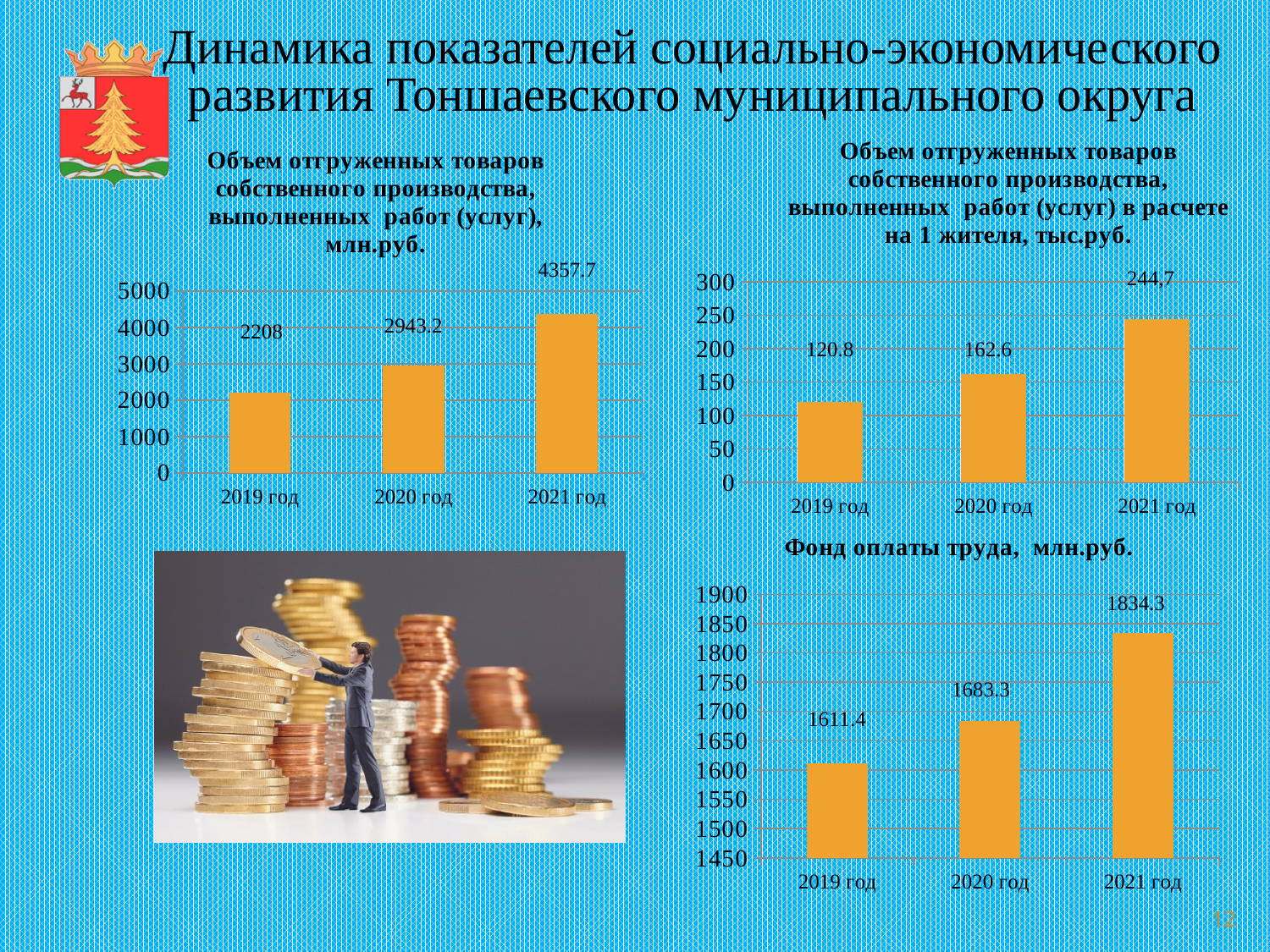
In the chart titled "Фонд оплаты труда, млн.руб.", what is the value for 2019 год? 1611.4 In the chart titled "Фонд оплаты труда, млн.руб.", which year has the highest value? 2021 год What type of chart is the chart titled "Фонд оплаты труда, млн.руб."? bar chart In the chart titled "Объем отгруженных товаров ... в расчете на 1 жителя, тыс.руб." (top right), what is the value for 2021 год? 244,7 In the chart titled "Объем отгруженных товаров собственного производства, выполненных работ (услуг), млн.руб.", what is the value for 2021 год? 4357.7 In the chart titled "Объем отгруженных товаров собственного производства, выполненных работ (услуг), млн.руб.", do the values rise or fall from 2019 год to 2021 год? rise In the chart titled "Объем отгруженных товаров собственного производства, выполненных работ (услуг), млн.руб.", what is the difference between the values for 2021 год and 2020 год? 1414.5 In the chart titled "Объем отгруженных товаров собственного производства, выполненных работ (услуг), млн.руб.", what is the value for 2019 год? 2208 In the chart titled "Фонд оплаты труда, млн.руб.", what is the difference between the values for 2021 год and 2019 год? 222.9 In the chart titled "Фонд оплаты труда, млн.руб.", how many years are shown on the x axis? 3 In the chart titled "Объем отгруженных товаров ... в расчете на 1 жителя, тыс.руб." (top right), which year has the lowest value? 2019 год In the chart titled "Объем отгруженных товаров ... в расчете на 1 жителя, тыс.руб." (top right), what is the value for 2020 год? 162.6